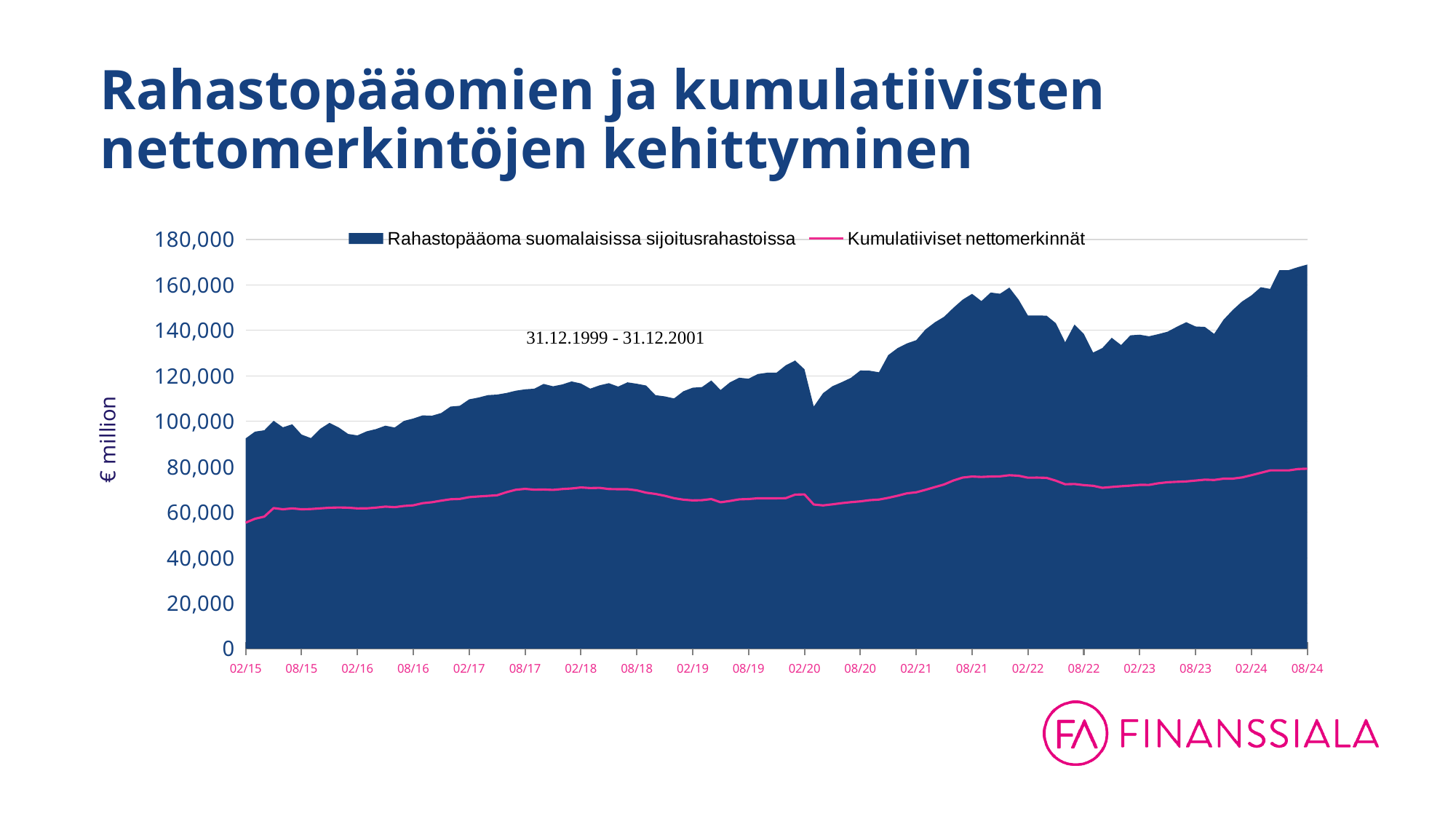
What is the label on the vertical axis? € million Is the value of Kumulatiiviset nettomerkinnät at 08/21 greater or less than 60,000? greater Is the value of Rahastopääoma suomalaisissa sijoitusrahastoissa at 02/15 greater or less than 100,000? less What are the two series named in the legend? Rahastopääoma suomalaisissa sijoitusrahastoissa and Kumulatiiviset nettomerkinnät How many date labels are shown on the horizontal axis? 20 What kind of chart is shown on the slide? An area chart with a line series Is the value of Kumulatiiviset nettomerkinnät at 02/15 greater or less than 60,000? less How many series does the legend list? 2 Does Rahastopääoma suomalaisissa sijoitusrahastoissa rise or fall overall from 02/15 to 08/24? rise At 08/24, which series has the larger value: Rahastopääoma suomalaisissa sijoitusrahastoissa or Kumulatiiviset nettomerkinnät? Rahastopääoma suomalaisissa sijoitusrahastoissa